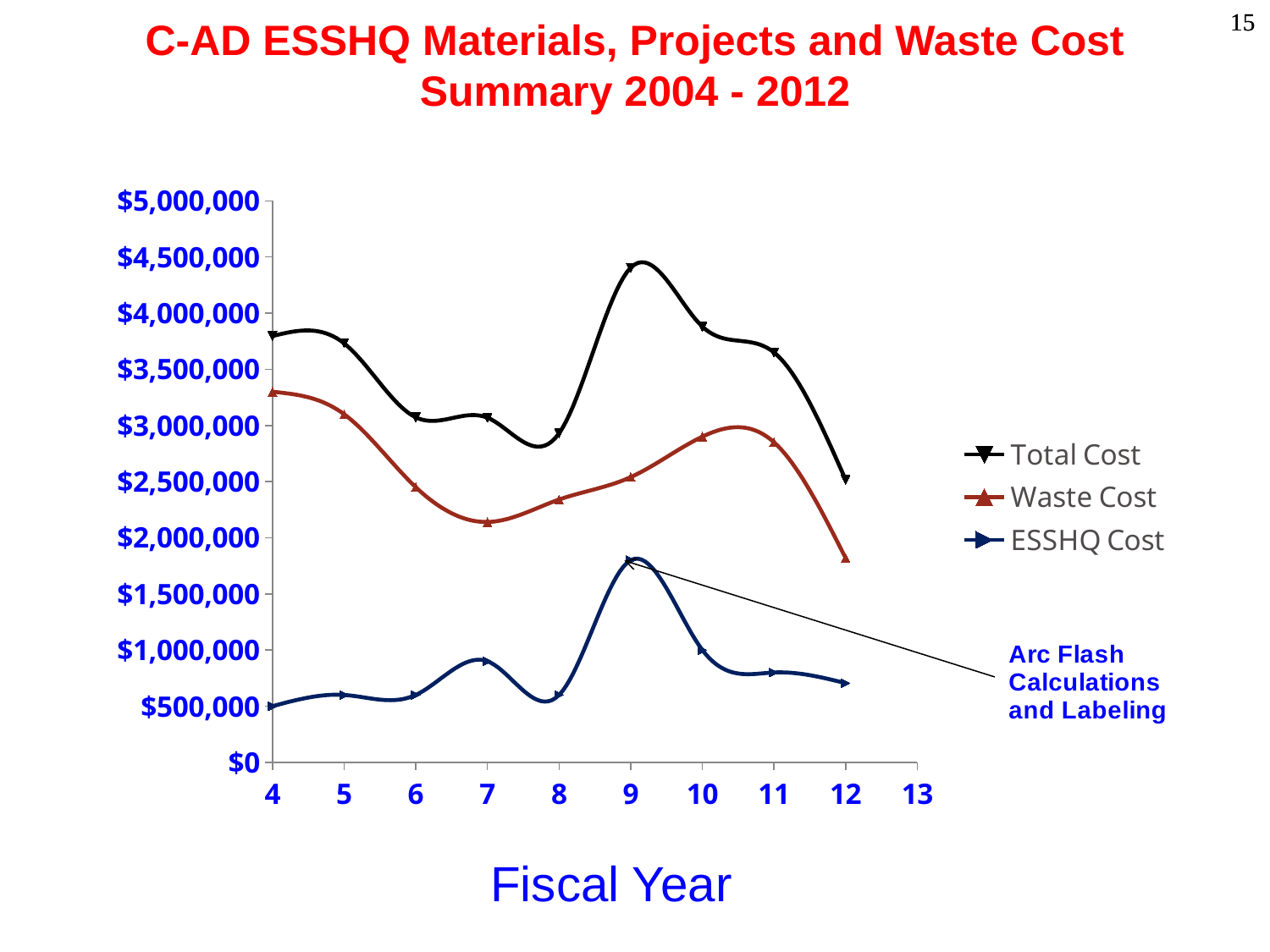
In which fiscal year is ESSHQ Cost highest? 9 How many fiscal years have data points plotted for the Total Cost series? 9 In which fiscal year is Total Cost highest? 9 Is the Total Cost value for fiscal year 9 greater or less than $4,000,000? greater In which fiscal year is Waste Cost lowest? 12 In which fiscal year is Total Cost lowest? 12 What kind of chart is shown on the slide? line chart Does Total Cost rise or fall from fiscal year 9 to fiscal year 12? fall Which is larger, Waste Cost in fiscal year 4 or Waste Cost in fiscal year 12? fiscal year 4 How many series does the legend list? 3 Is the Waste Cost value for fiscal year 7 greater or less than $2,500,000? less Is the ESSHQ Cost value for fiscal year 9 greater or less than $1,500,000? greater